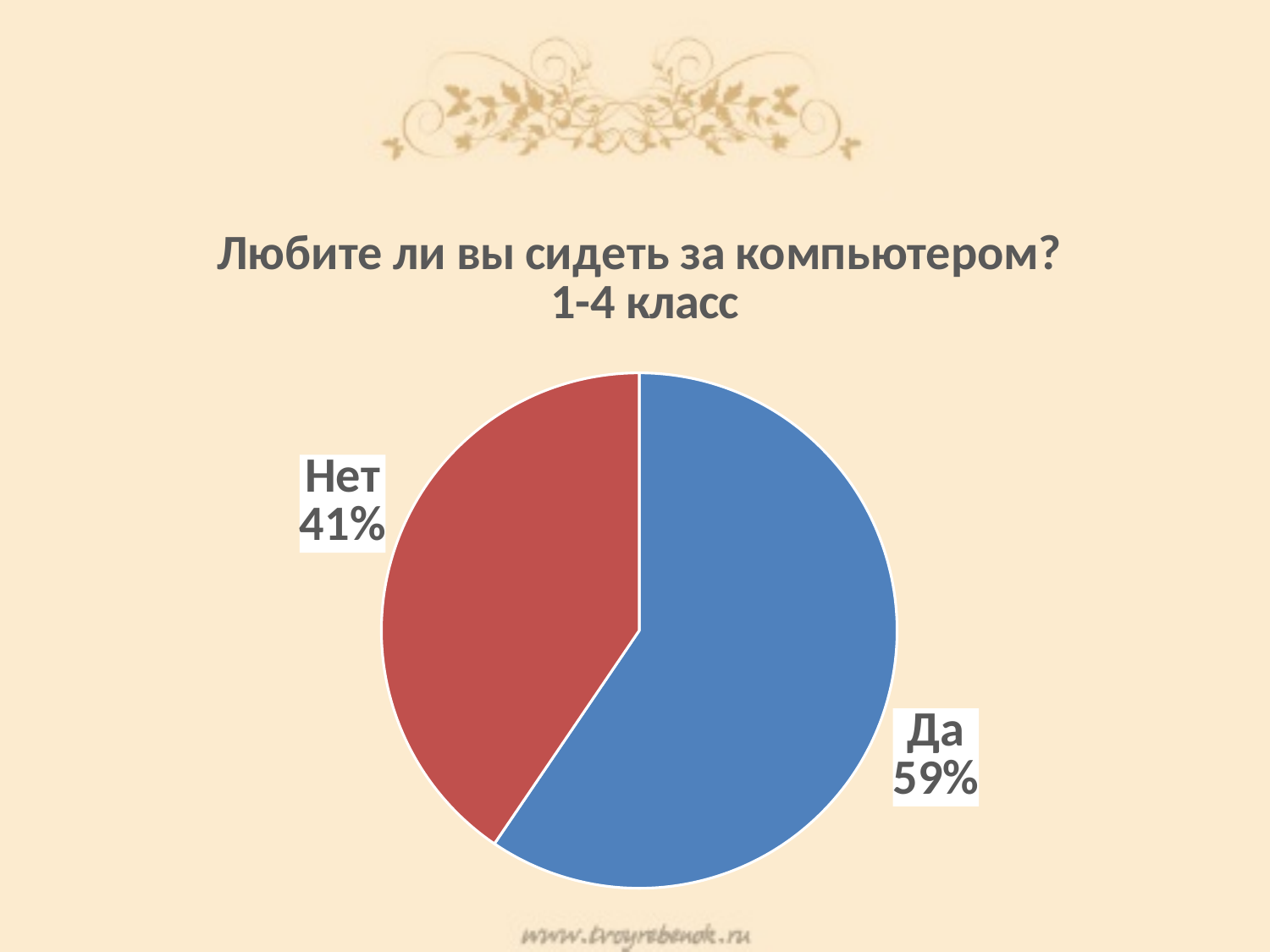
What share of the pie does the "Да" slice represent? 59% What is the difference in percentage points between the "Да" and "Нет" slices? 18 percentage points How many slices does the pie chart have? 2 What kind of chart is shown on the slide? Pie chart Is the value for "Нет" greater or less than 50%? less Is the value for "Да" greater or less than 50%? greater Which is larger, the "Да" slice or the "Нет" slice? Да Which slice is the smallest in the pie chart? Нет What share of the pie does the "Нет" slice represent? 41% Which slice is the largest in the pie chart? Да What is the title of the chart? Любите ли вы сидеть за компьютером? 1-4 класс What colour is the "Нет" slice? Red